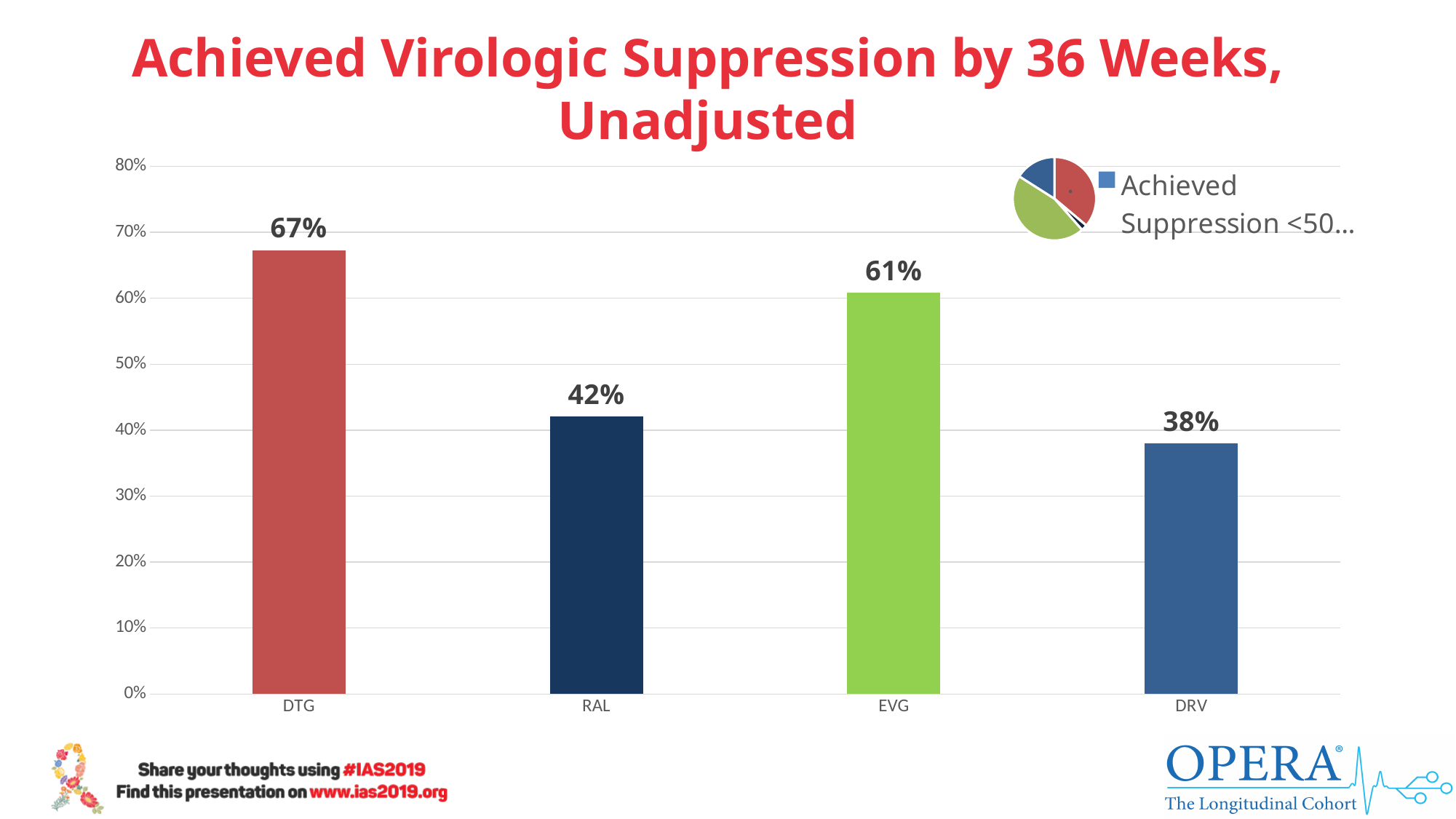
In the bar chart, what is the difference between the values for DTG and DRV? 29% In the bar chart, which category has the highest value? DTG In the bar chart, what is the value for RAL? 42% What kind of chart is the large chart on the slide? Bar chart In the bar chart, which is larger, the value for RAL or the value for EVG? EVG In the bar chart, how many categories are shown on the x axis? 4 In the bar chart, what is the difference between the values for EVG and RAL? 19% In the bar chart, what is the value for DRV? 38% What is the title of the slide's chart? Achieved Virologic Suppression by 36 Weeks, Unadjusted In the bar chart, what is the value for EVG? 61% In the bar chart, which category has the lowest value? DRV In the bar chart, what is the value for DTG? 67%